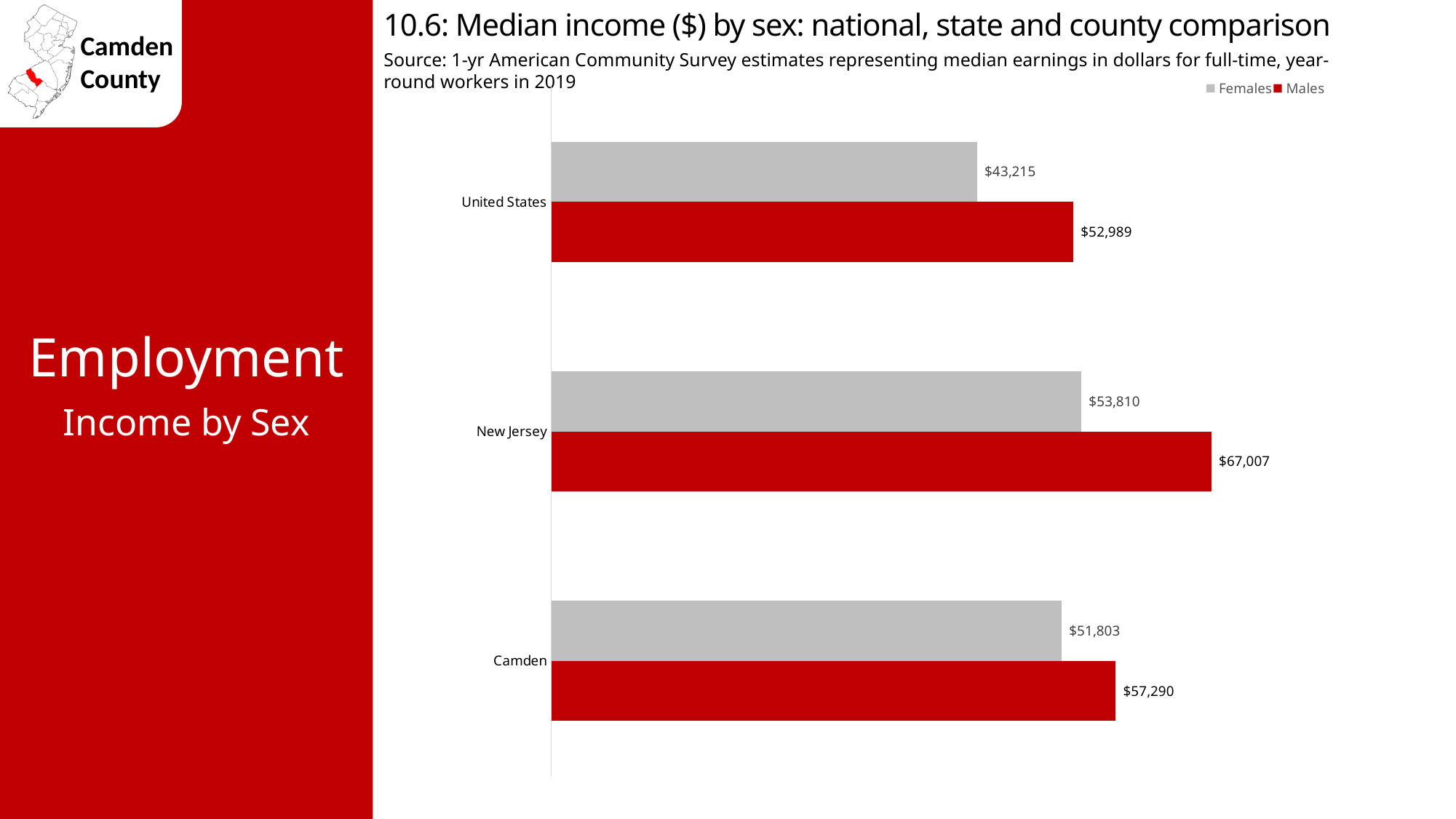
What is the difference between Males and Females median income in the United States? $9,774 How many categories are shown on the chart? 3 What kind of chart is shown on the slide? Bar chart Which category has the highest median income for Males? New Jersey What is the difference between Males and Females median income in New Jersey? $13,197 What is the median income for Males in Camden? $57,290 What is the median income for Males in New Jersey? $67,007 Which is larger: the Females median income in New Jersey or the Males median income in the United States? Females median income in New Jersey Which category has the lowest median income for Females? United States What is the median income for Females in the United States? $43,215 What is the median income for Females in Camden? $51,803 How many series does the legend list? 2